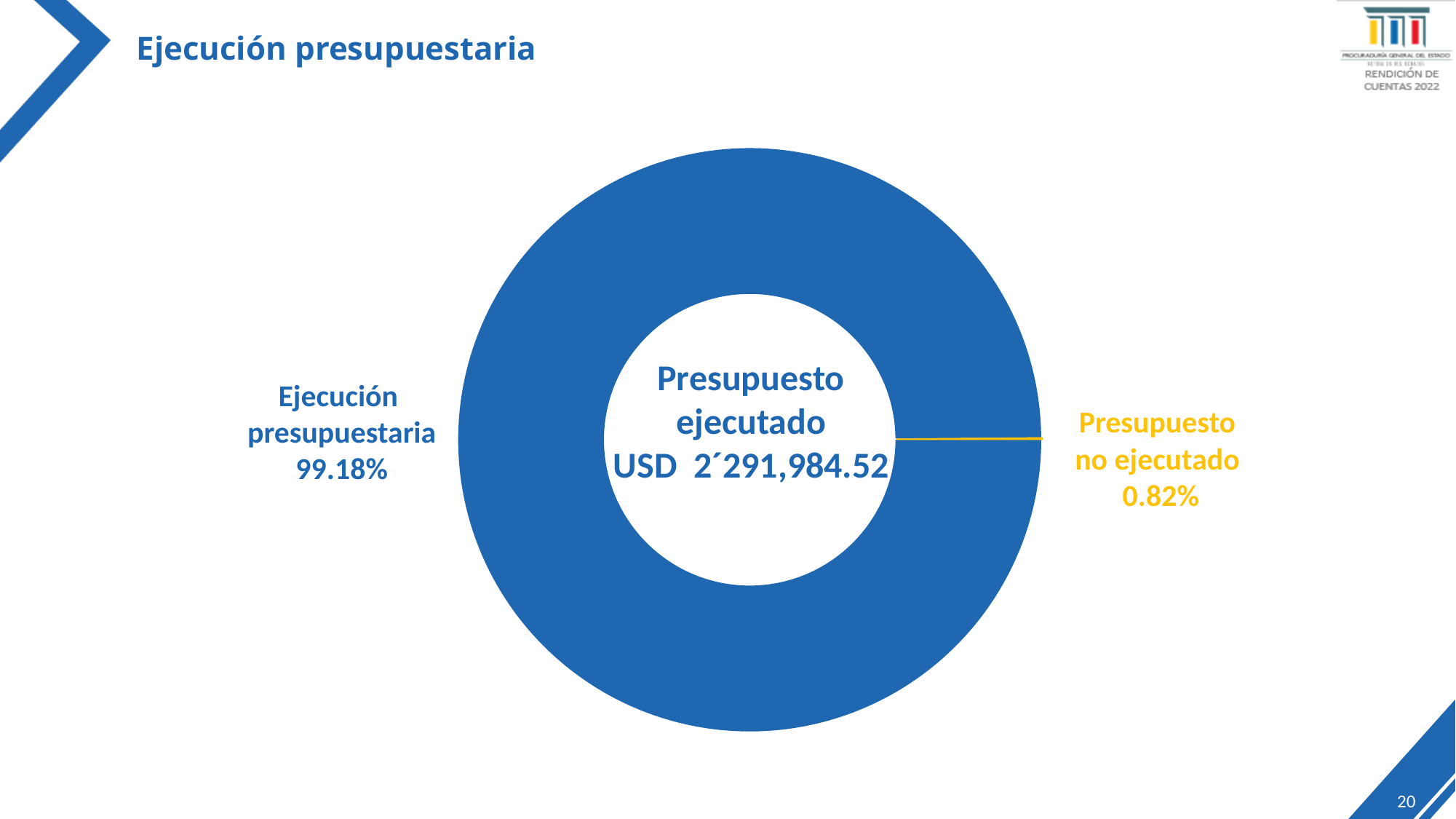
What colour is the 'Presupuesto no ejecutado' slice? Yellow What amount of executed budget is printed in the centre of the chart? USD 2´291,984.52 What is the title of the slide containing the chart? Ejecución presupuestaria Which is larger, the 'Ejecución presupuestaria' share or the 'Presupuesto no ejecutado' share? Ejecución presupuestaria Which slice of the chart is the smallest? Presupuesto no ejecutado How many slices does the chart have? 2 What share of the budget does the 'Presupuesto no ejecutado' slice represent? 0.82% What share of the budget does the 'Ejecución presupuestaria' slice represent? 99.18% Which slice of the chart is the largest? Ejecución presupuestaria What kind of chart is shown on the slide? Doughnut (pie) chart What is the difference in percentage points between the 'Ejecución presupuestaria' share and the 'Presupuesto no ejecutado' share? 98.36